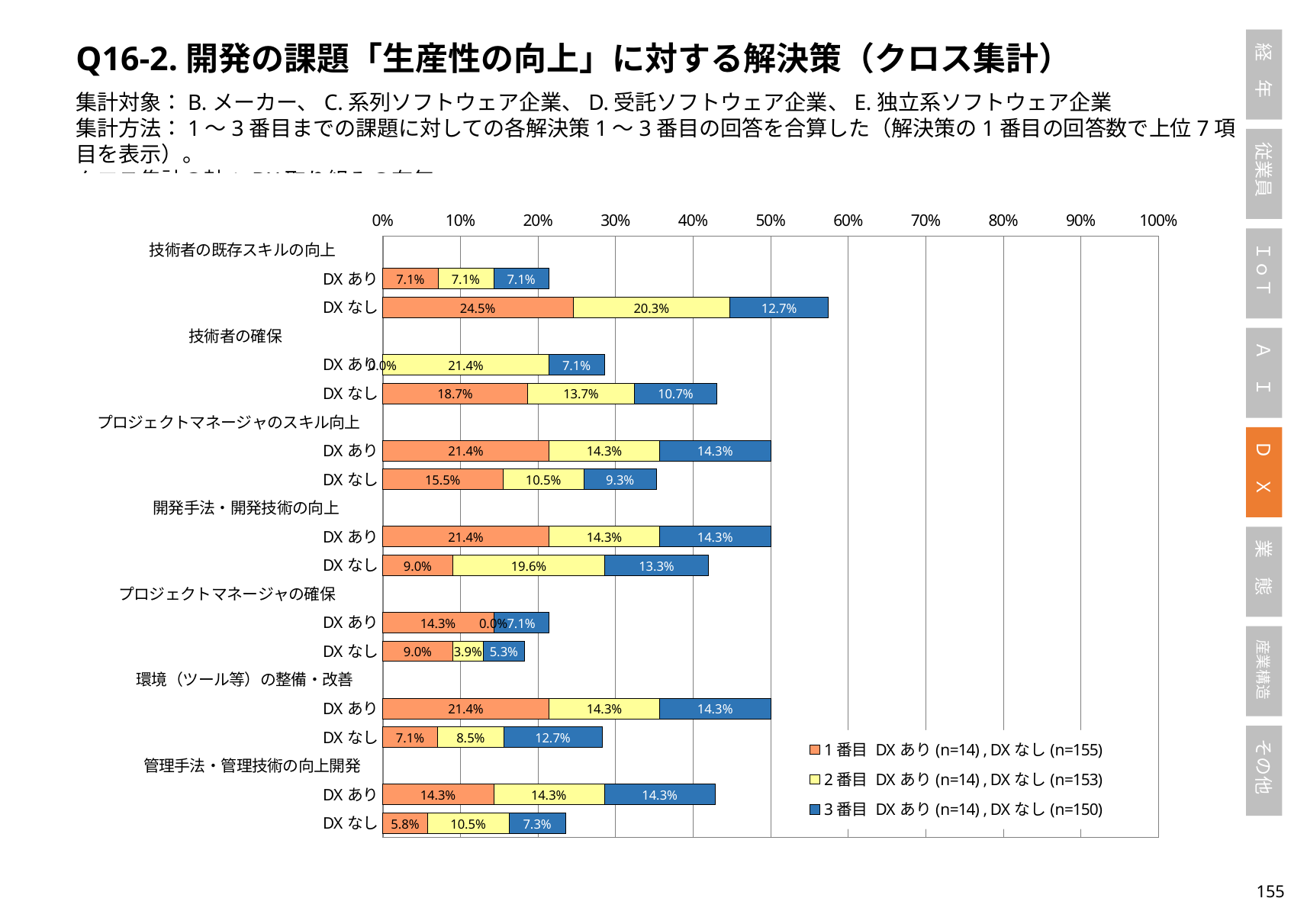
Which bar has the highest 1番目 value? 技術者の既存スキルの向上, DXなし What kind of chart is shown on the slide? stacked bar chart What is the difference between the 1番目 values for 技術者の既存スキルの向上 DXなし (24.5%) and DXあり (7.1%)? 17.4 percentage points What is the 3番目 value for 開発手法・開発技術の向上, DXなし? 13.3% How many solution categories are shown on the vertical axis? 7 What is the 2番目 value for プロジェクトマネージャの確保, DXなし? 3.9% How many series does the legend list? 3 What is the total of the stacked bar for 技術者の既存スキルの向上, DXあり? 21.3% Which is larger: the 1番目 value for 技術者の確保 DXなし or the 1番目 value for 管理手法・管理技術の向上開発 DXなし? 技術者の確保 DXなし What is the 2番目 value for 技術者の確保, DXあり? 21.4% What is the total of the stacked bar for 技術者の既存スキルの向上, DXなし? 57.5% What is the 1番目 value for 技術者の既存スキルの向上, DXなし? 24.5%